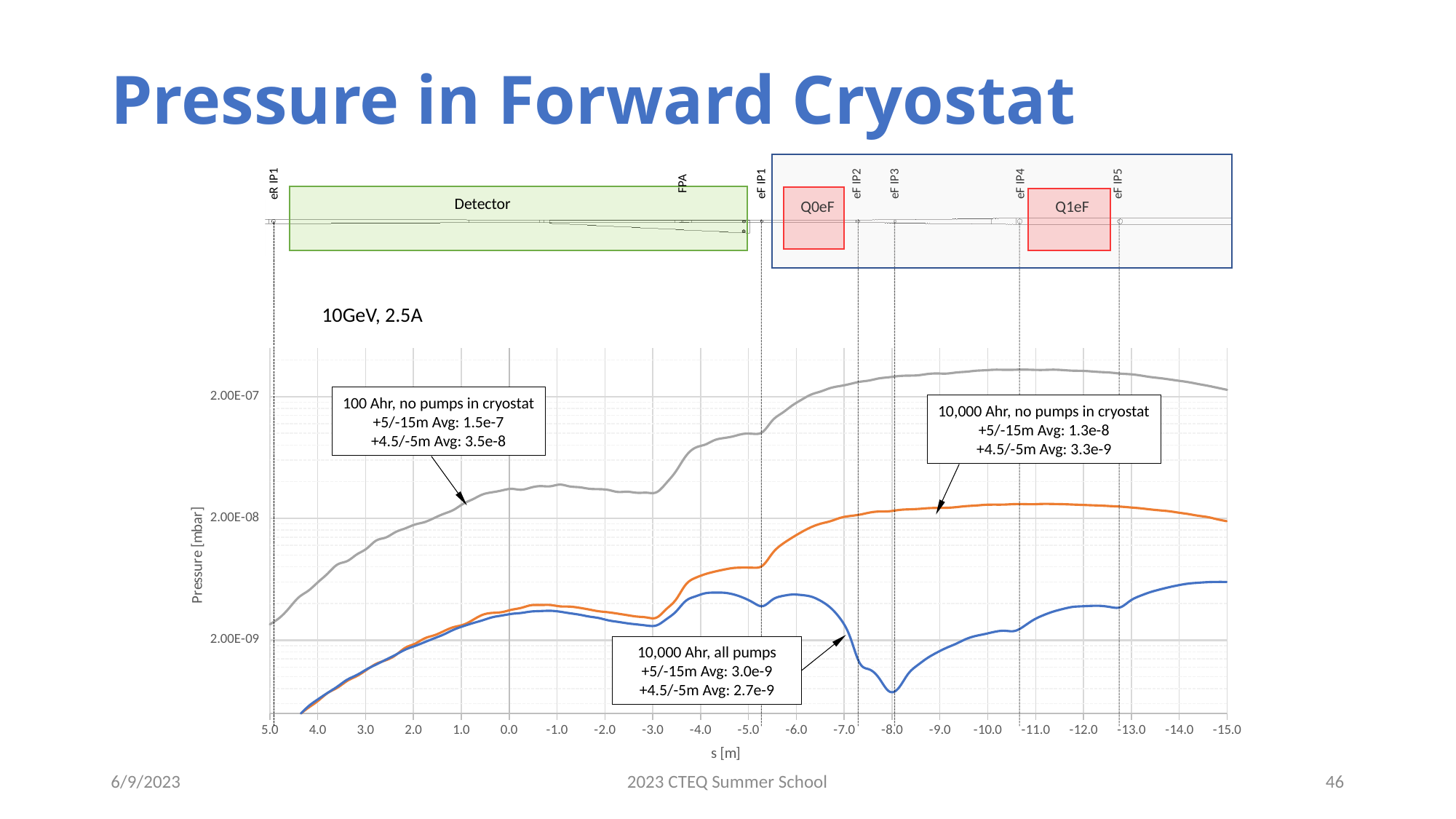
Is the pressure of the 10,000 Ahr, all pumps curve at s = -8.0 m greater or less than 2.00E-09 mbar? less Which is larger, the +5/-15m average for 10,000 Ahr with no pumps in cryostat or the +5/-15m average for 10,000 Ahr with all pumps? 10,000 Ahr, no pumps in cryostat What kind of chart is shown on the slide? line chart What is the +5/-15m average pressure for the 100 Ahr, no pumps in cryostat case? 1.5e-7 What is the +4.5/-5m average pressure for the 10,000 Ahr, all pumps case? 2.7e-9 Which curve has the lowest pressure across the plotted range? 10,000 Ahr, all pumps What is the +4.5/-5m average pressure for the 10,000 Ahr, no pumps in cryostat case? 3.3e-9 What beam condition is written above the chart? 10GeV, 2.5A Which curve has the highest pressure across the plotted range? 100 Ahr, no pumps in cryostat How many pressure curves are plotted on the chart? 3 What is the label of the vertical axis of the chart? Pressure [mbar] Is the pressure of the 100 Ahr, no pumps in cryostat curve at s = -10.0 m greater or less than 2.00E-07 mbar? greater